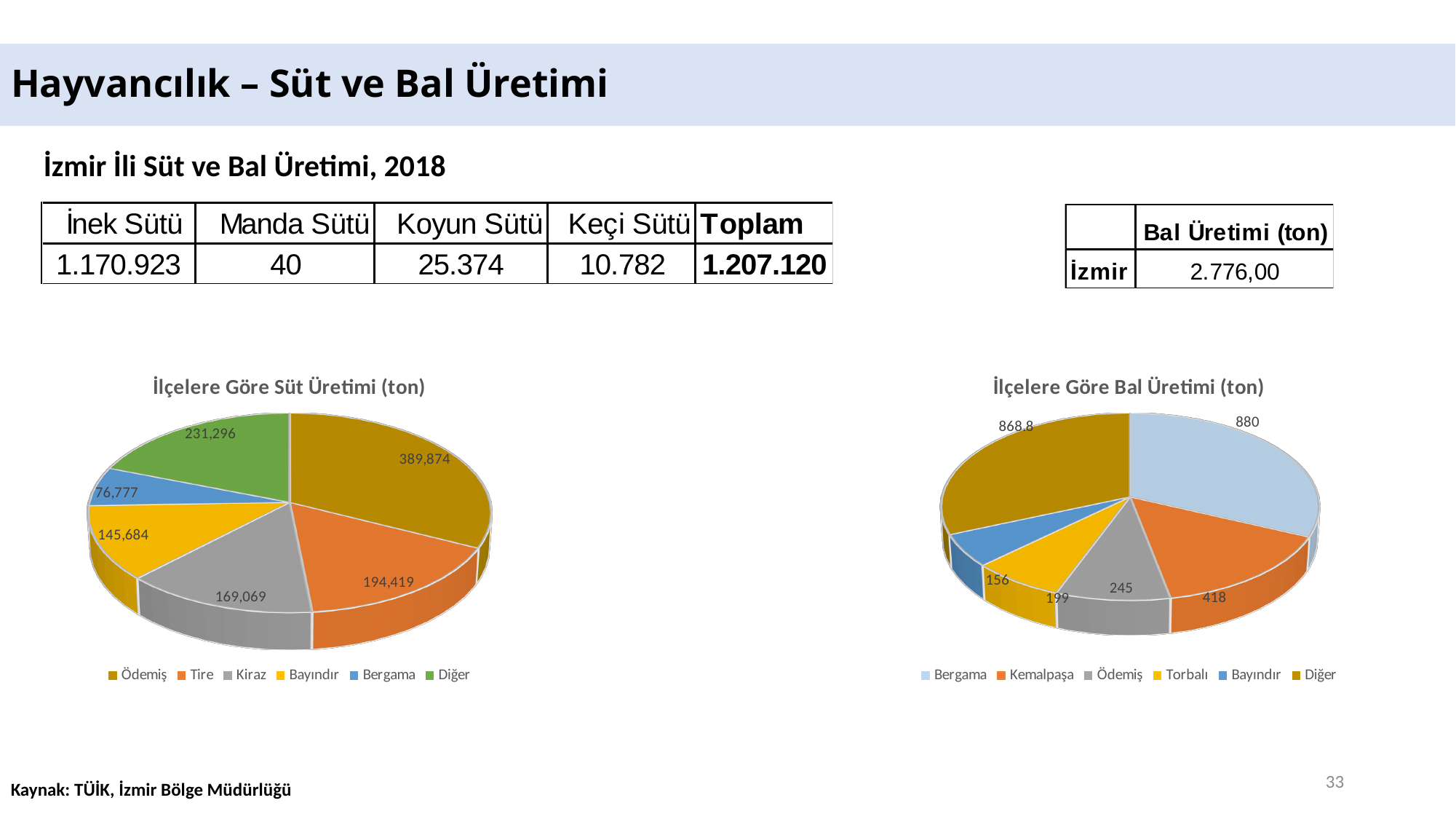
In the 'İlçelere Göre Bal Üretimi (ton)' chart, which category has the smallest value? Bayındır In the 'İlçelere Göre Süt Üretimi (ton)' chart, which district has the largest slice? Ödemiş In the 'İlçelere Göre Bal Üretimi (ton)' chart, what is the value for Diğer? 868,8 In the 'İlçelere Göre Süt Üretimi (ton)' chart, which is larger, Bayındır or Bergama? Bayındır In the 'İlçelere Göre Bal Üretimi (ton)' chart, what is the value for Kemalpaşa? 418 In the 'İlçelere Göre Süt Üretimi (ton)' chart, what is the difference between Ödemiş and Tire? 195,455 How many slices does the 'İlçelere Göre Bal Üretimi (ton)' chart have? 6 In the 'İlçelere Göre Süt Üretimi (ton)' chart, what is the value for Kiraz? 169,069 In the 'İlçelere Göre Bal Üretimi (ton)' chart, what is the difference between Bergama and Kemalpaşa? 462 In the 'İlçelere Göre Süt Üretimi (ton)' chart, what is the value for Ödemiş? 389,874 What type of chart is 'İlçelere Göre Süt Üretimi (ton)'? Pie chart In the 'İlçelere Göre Süt Üretimi (ton)' chart, which district has the smallest slice? Bergama